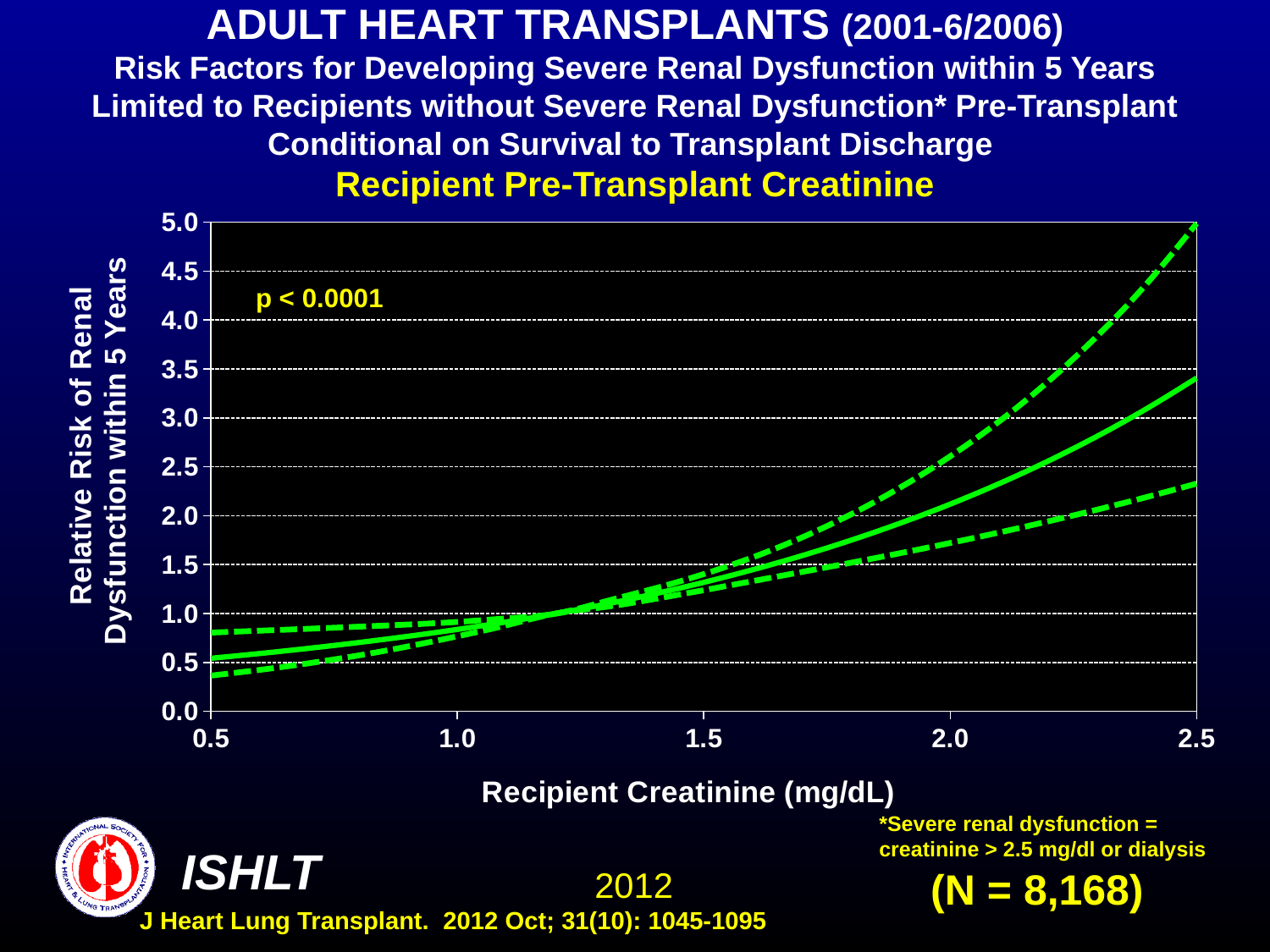
What p-value is printed on the chart? p < 0.0001 Is the relative risk on the solid line at a recipient creatinine of 1.5 mg/dL greater or less than 1.0? greater How many lines are plotted on the chart? 3 Is the relative risk on the solid line at a recipient creatinine of 2.5 mg/dL greater or less than 3.0? greater What kind of chart is shown on the slide? line chart Is the relative risk on the solid line at a recipient creatinine of 0.5 mg/dL greater or less than 1.0? less What is the label of the x axis? Recipient Creatinine (mg/dL) Does the relative risk shown by the solid line rise or fall as recipient creatinine increases from 0.5 to 2.5 mg/dL? rise